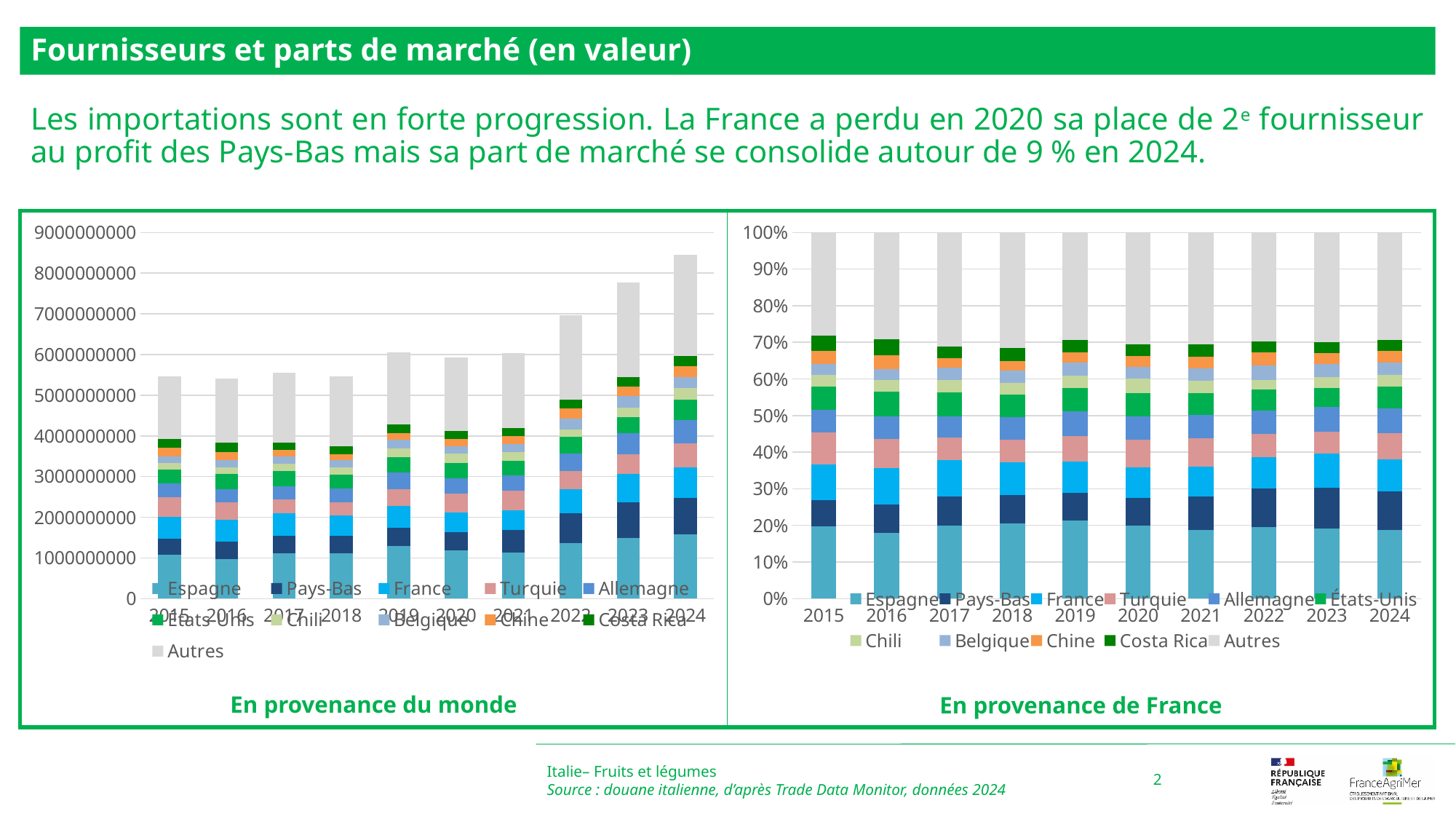
In the 'En provenance du monde' chart, do the total bars generally rise or fall from 2015 to 2024? rise Which series is listed first in the legend of the 'En provenance de France' chart? Espagne In the 'En provenance du monde' chart, is the total for 2015 greater or less than 6000000000? less In the 'En provenance du monde' chart, which year has the highest total bar? 2024 In the 'En provenance de France' chart, is the share of 'Autres' in 2024 greater or less than 20%? greater In the 'En provenance de France' chart, how many series does the legend list? 11 What kind of chart is the 'En provenance du monde' chart on the left? stacked bar chart What kind of chart is the 'En provenance de France' chart on the right? 100% stacked bar chart In the 'En provenance du monde' chart, how many years are shown on the x axis? 10 In the 'En provenance du monde' chart, which total is larger, 2022 or 2019? 2022 In the 'En provenance du monde' chart, is the total for 2024 greater or less than 8000000000? greater